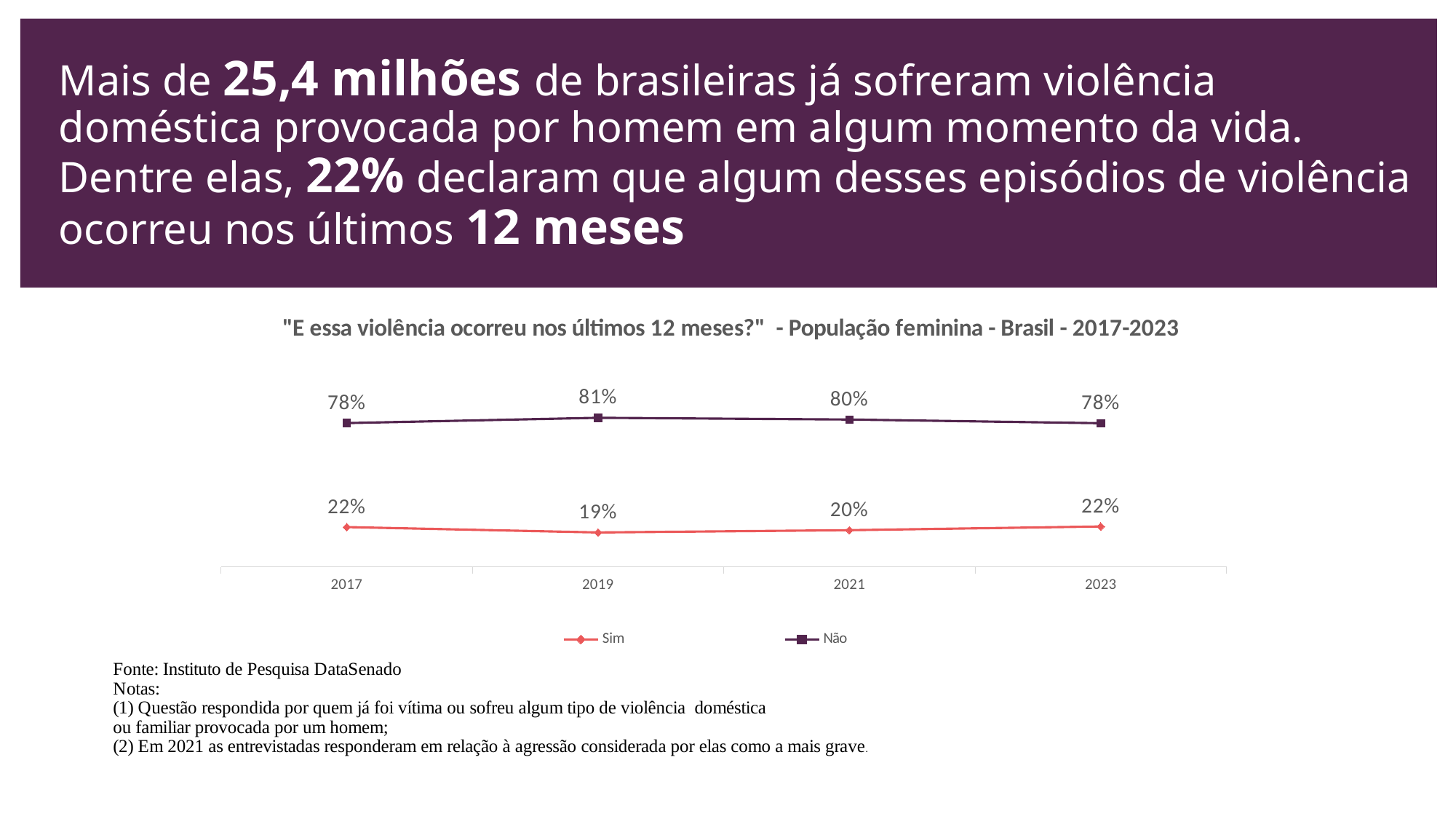
What is the value for "Sim" in 2019? 19% Which is larger in 2021, the "Sim" value or the "Não" value? Não What is the value for "Sim" in 2023? 22% What is the difference between the "Não" value and the "Sim" value in 2017? 56% How many years are plotted on the x axis? 4 In which year is the "Sim" series lowest? 2019 What is the value for "Não" in 2021? 80% What is the difference between the "Sim" value in 2023 and the "Sim" value in 2019? 3% What type of chart is shown on the slide? line chart What is the title of the chart? "E essa violência ocorreu nos últimos 12 meses?" - População feminina - Brasil - 2017-2023 How many series does the legend list? 2 In which year is the "Não" series highest? 2019